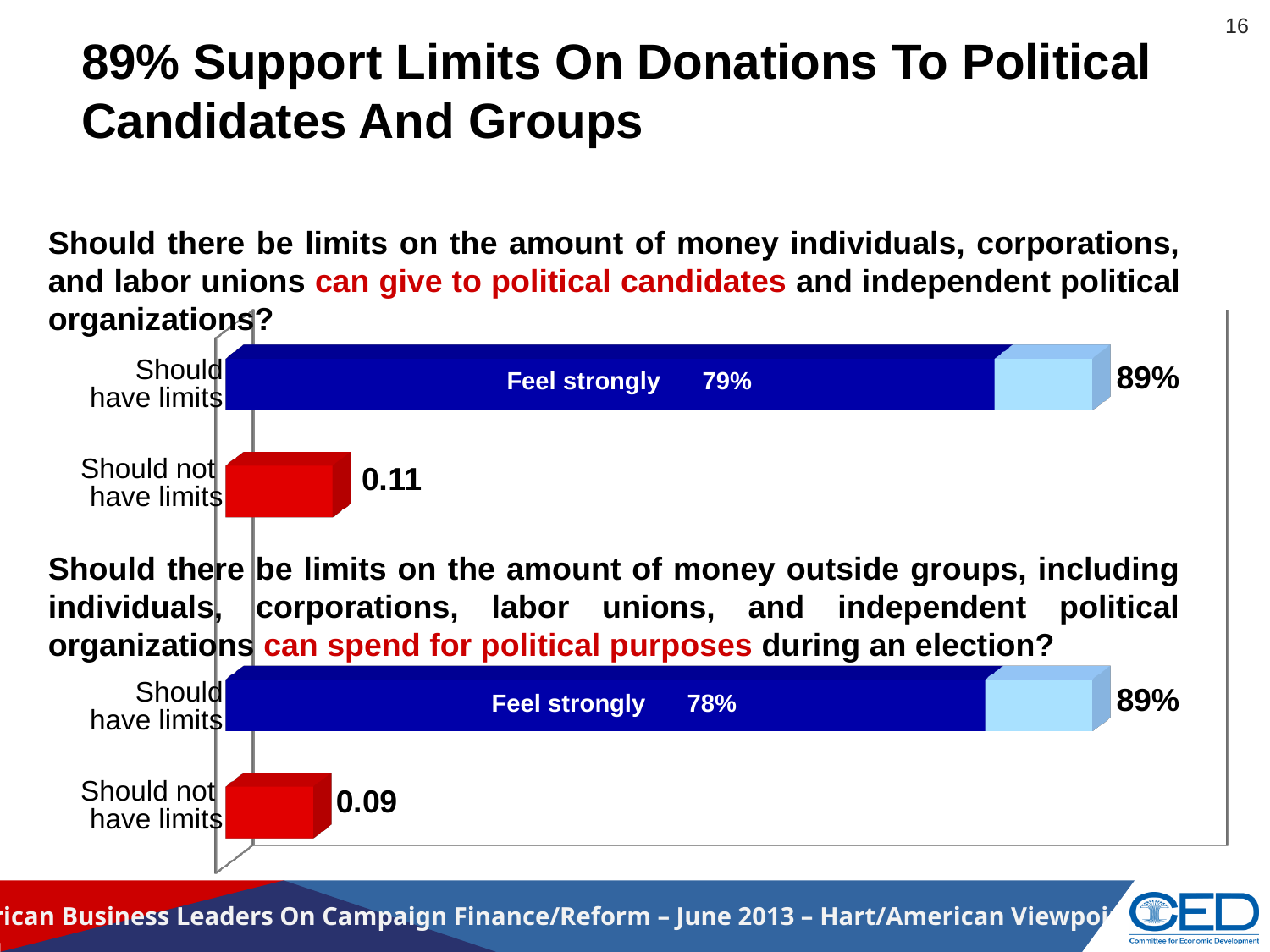
In the bottom chart, what is the value labelled for "Should not have limits"? 0.09 What is the difference between the "Feel strongly" percentages in the top chart and the bottom chart? 1% In the top chart, what is the value for "Should have limits"? 89% In the bottom chart, what is the value for "Should have limits"? 89% In the top chart, what percentage is shown for "Feel strongly" within the "Should have limits" bar? 79% Which chart shows a larger "Feel strongly" percentage, the top chart or the bottom chart? The top chart In the bottom chart, what percentage is shown for "Feel strongly" within the "Should have limits" bar? 78% What type of chart is the bottom chart? Bar chart In the top chart, which category has the highest value? Should have limits How many categories are shown in the top chart? 2 In the top chart, what is the value labelled for "Should not have limits"? 0.11 In the bottom chart, which category has the lowest value? Should not have limits